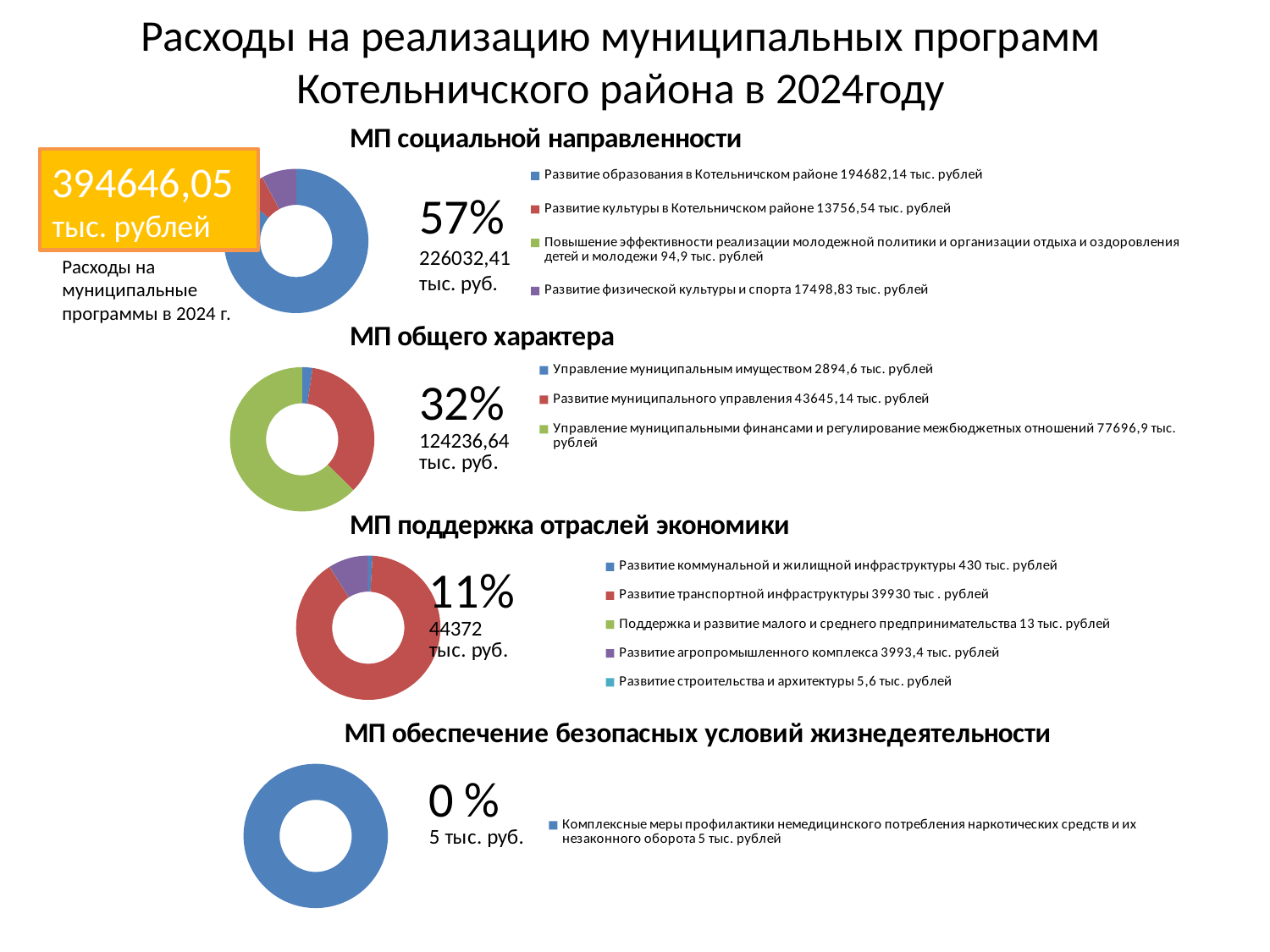
In the chart 'МП поддержка отраслей экономики', how many categories does the legend list? 5 In the chart 'МП общего характера', which category has the largest value? Управление муниципальными финансами и регулирование межбюджетных отношений What percentage share is shown next to the chart 'МП общего характера'? 32% In the chart 'МП поддержка отраслей экономики', which is larger: 'Развитие коммунальной и жилищной инфраструктуры' or 'Развитие строительства и архитектуры'? Развитие коммунальной и жилищной инфраструктуры What total amount is shown next to the chart 'МП поддержка отраслей экономики'? 44372 тыс. руб. In the chart 'МП социальной направленности', what is the value for 'Развитие образования в Котельничском районе'? 194682,14 тыс. рублей In the chart 'МП общего характера', what is the difference between 'Управление муниципальными финансами и регулирование межбюджетных отношений' and 'Развитие муниципального управления'? 34051,76 тыс. рублей In the chart 'МП общего характера', what is the value for 'Развитие муниципального управления'? 43645,14 тыс. рублей In the chart 'МП социальной направленности', how many categories does the legend list? 4 In the chart 'МП социальной направленности', which category has the smallest value? Повышение эффективности реализации молодежной политики и организации отдыха и оздоровления детей и молодежи What kind of chart is used for 'МП обеспечение безопасных условий жизнедеятельности'? Doughnut chart In the chart 'МП поддержка отраслей экономики', what is the value for 'Развитие агропромышленного комплекса'? 3993,4 тыс. рублей